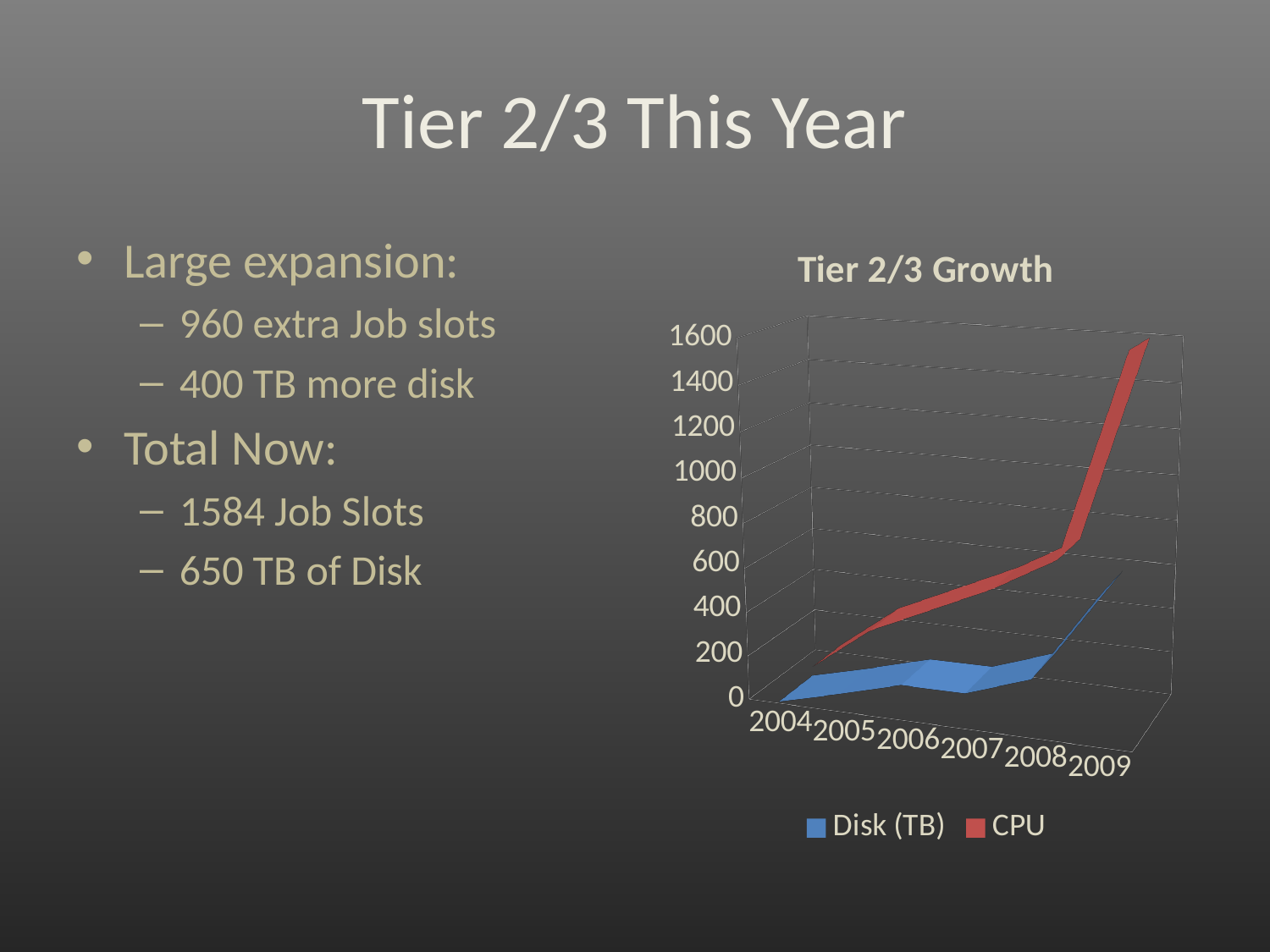
How many series does the chart's legend list? 2 In 2009, which series has the larger value, Disk (TB) or CPU? CPU Is the CPU value for 2009 greater or less than 1000? greater Is the CPU value for 2005 greater or less than 800? less What kind of chart is shown on the slide? line chart Which year is the first on the x axis of the chart? 2004 How many years are shown along the x axis of the chart? 6 What are the two series named in the legend? Disk (TB) and CPU What is the title of the chart? Tier 2/3 Growth Does the CPU series rise or fall from 2004 to 2009? rise Is the Disk (TB) value for 2009 greater or less than 200? greater In which year does the CPU series reach its highest value? 2009